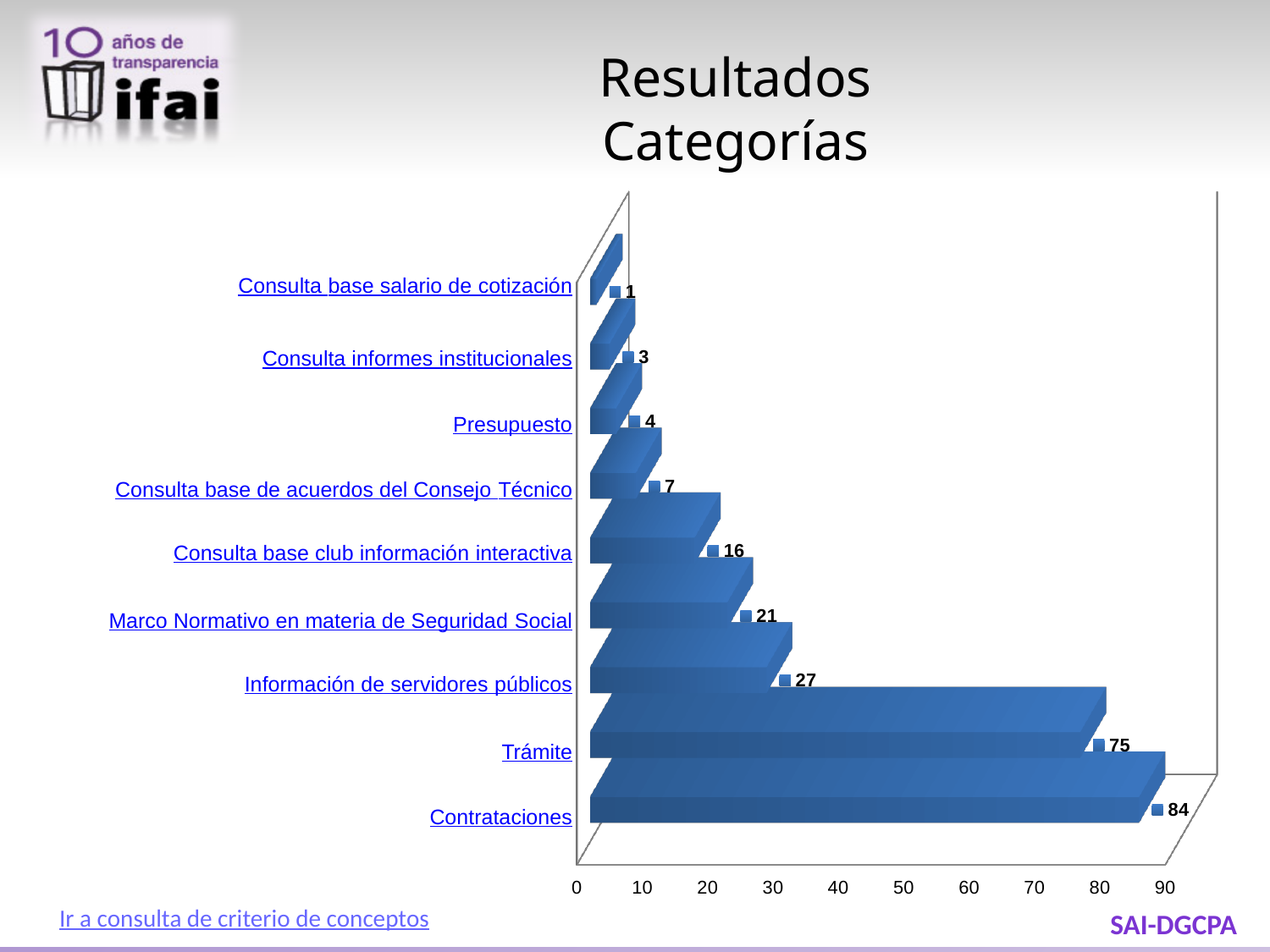
What is the difference between the values for Contrataciones and Trámite? 9 What is the value for Trámite? 75 What is the title of the slide containing the chart? Resultados Categorías What kind of chart is shown on the slide? Bar chart What is the difference between the values for Información de servidores públicos and Marco Normativo en materia de Seguridad Social? 6 Which category has the highest value? Contrataciones What is the value for Contrataciones? 84 Which is larger, the value for Marco Normativo en materia de Seguridad Social or the value for Presupuesto? Marco Normativo en materia de Seguridad Social What is the value for Consulta base club información interactiva? 16 What is the value for Información de servidores públicos? 27 How many categories are shown in the chart? 9 Which category has the lowest value? Consulta base salario de cotización